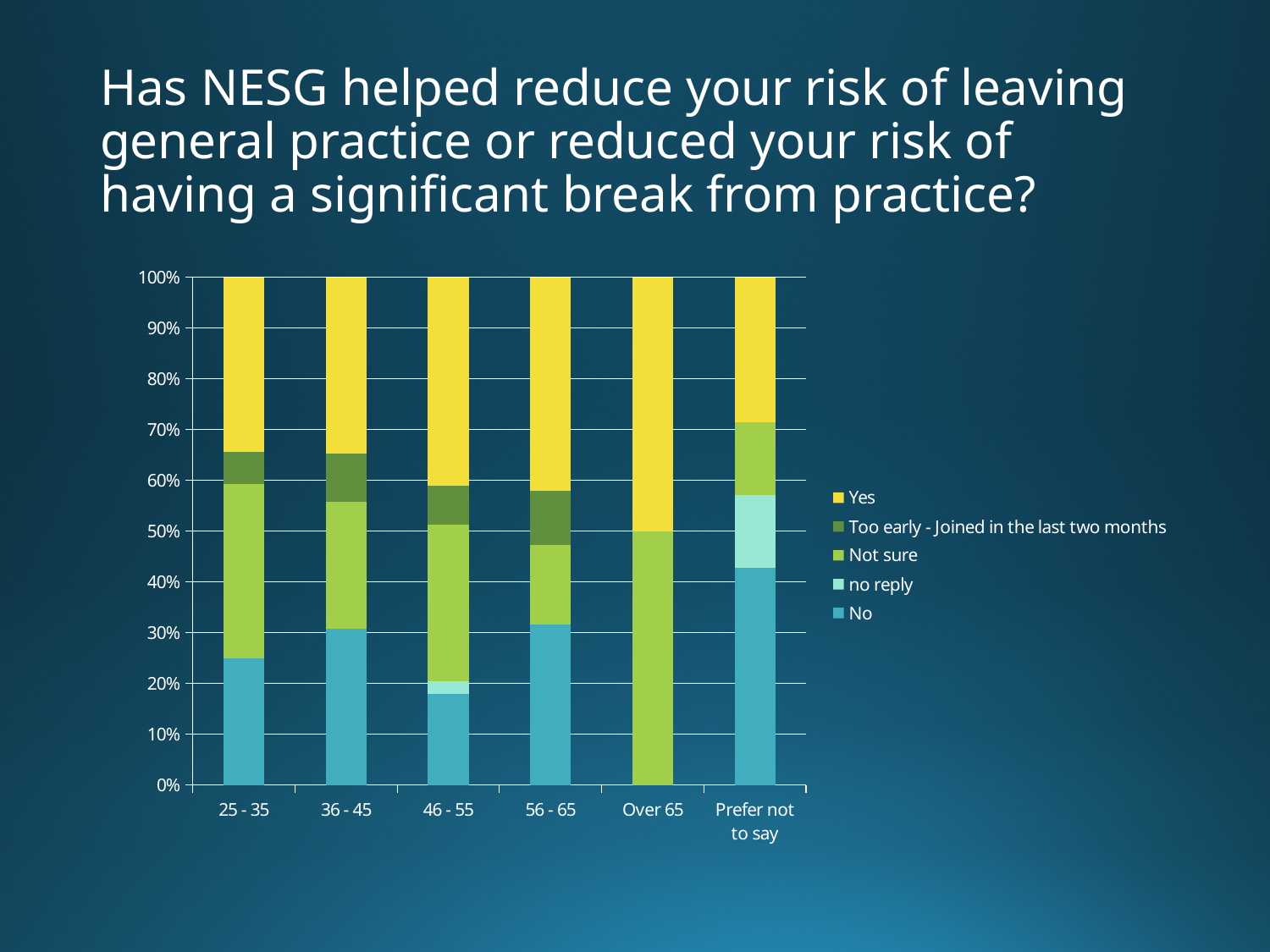
What kind of chart is shown on the slide? Stacked bar chart Is the 'No' share for 25 - 35 greater or less than 30%? less How many series does the legend list? 5 Which category has the smallest 'Yes' share? Prefer not to say How many age-group categories are shown on the x axis? 6 Which has the larger 'No' share, 36 - 45 or 25 - 35? 36 - 45 Which category's bar contains no 'No' segment at all? Over 65 Which category has the largest 'No' share? Prefer not to say Which category has the largest 'Yes' share? Over 65 Which has the larger 'No' share, 56 - 65 or 46 - 55? 56 - 65 Is the 'No' share for Prefer not to say greater or less than 30%? greater Is the 'Yes' share for Over 65 greater or less than 40%? greater